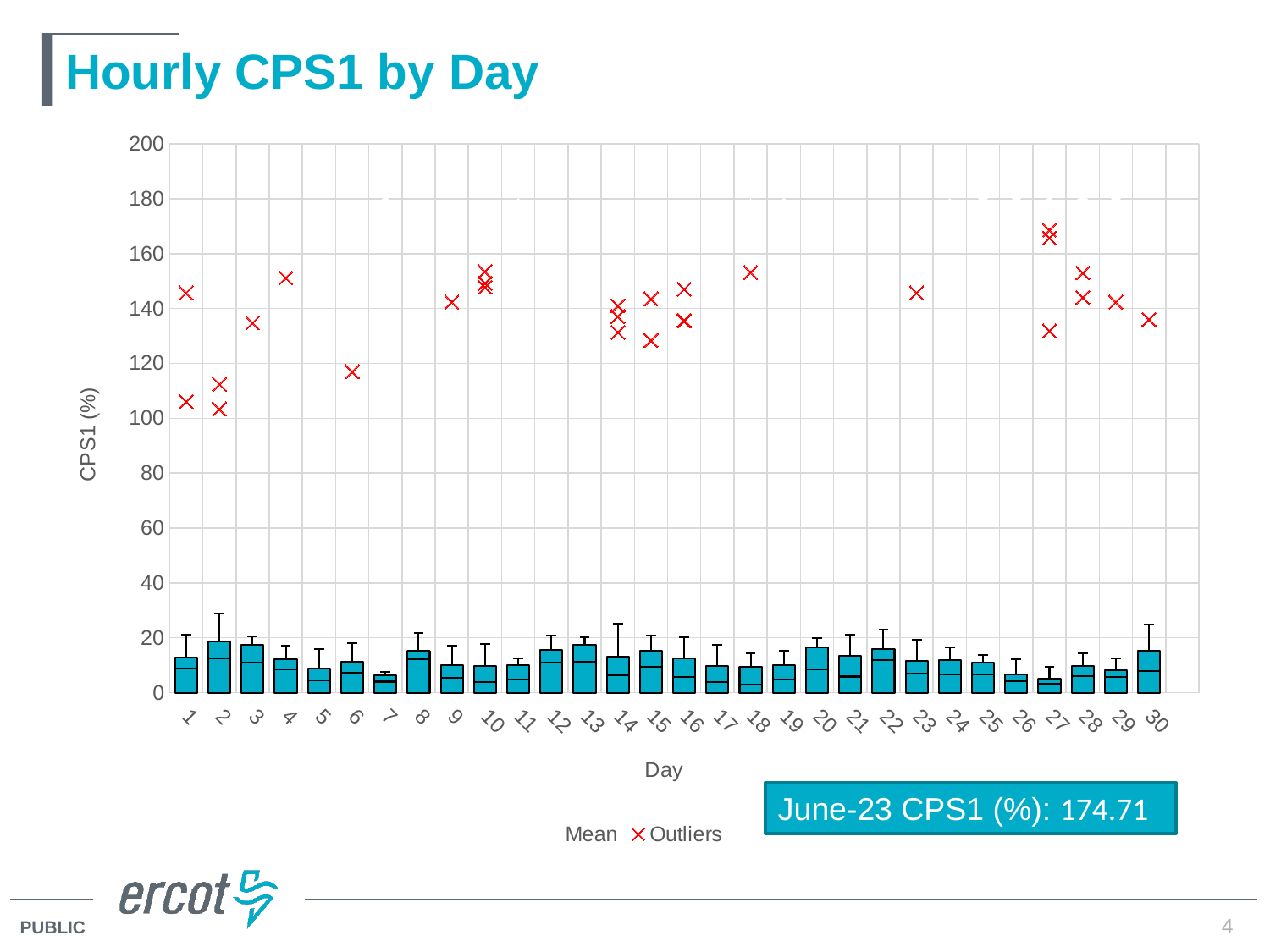
How many days are shown along the x axis of the chart? 30 Which day has the highest outlier value in the chart? 27 Which is larger, the outlier for day 4 or the outlier for day 3? Day 4 What June-23 CPS1 (%) value is printed in the box on the slide? 174.71 Is the outlier for day 6 greater or less than 120? less How many entries does the chart legend list? 2 What is the title of the chart? Hourly CPS1 by Day How many outliers are plotted for day 1? 2 What kind of chart is shown on the slide? Box plot Is the highest outlier for day 27 greater or less than 160? greater What is the label of the y axis? CPS1 (%)